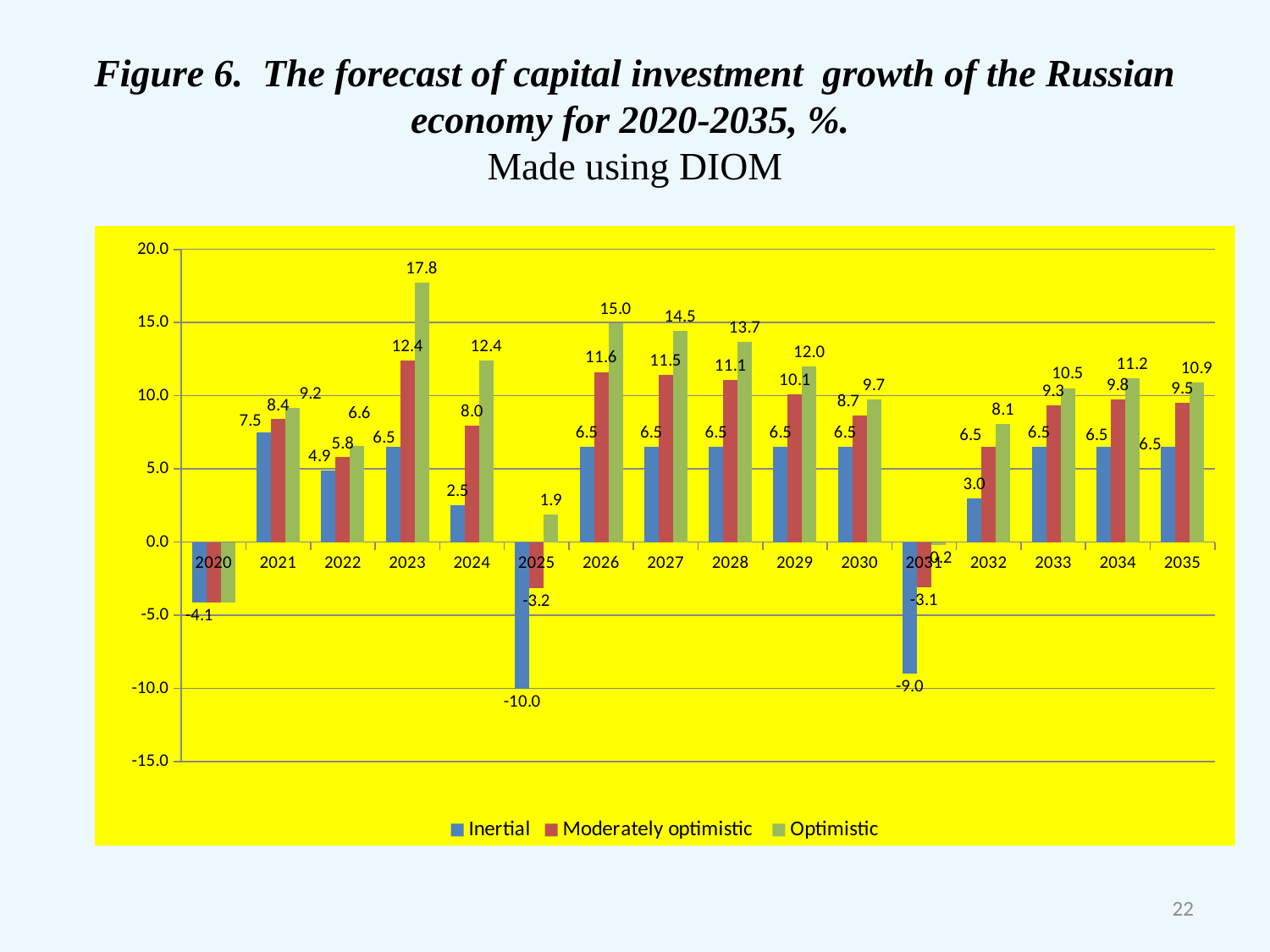
What is the difference between the Optimistic and Moderately optimistic values in 2023? 5.4 What is the Inertial value for 2032? 3.0 What is the Optimistic value for 2023? 17.8 In which year is the Inertial value lowest? 2025 Which year has the larger Optimistic value, 2026 or 2027? 2026 How many series does the legend list? 3 What kind of chart is shown on the slide? bar chart What is the Inertial value for 2025? -10.0 How many years are shown on the x axis? 16 What is the Moderately optimistic value for 2029? 10.1 In which year is the Optimistic value highest? 2023 Do the Optimistic values rise or fall from 2026 to 2030? fall